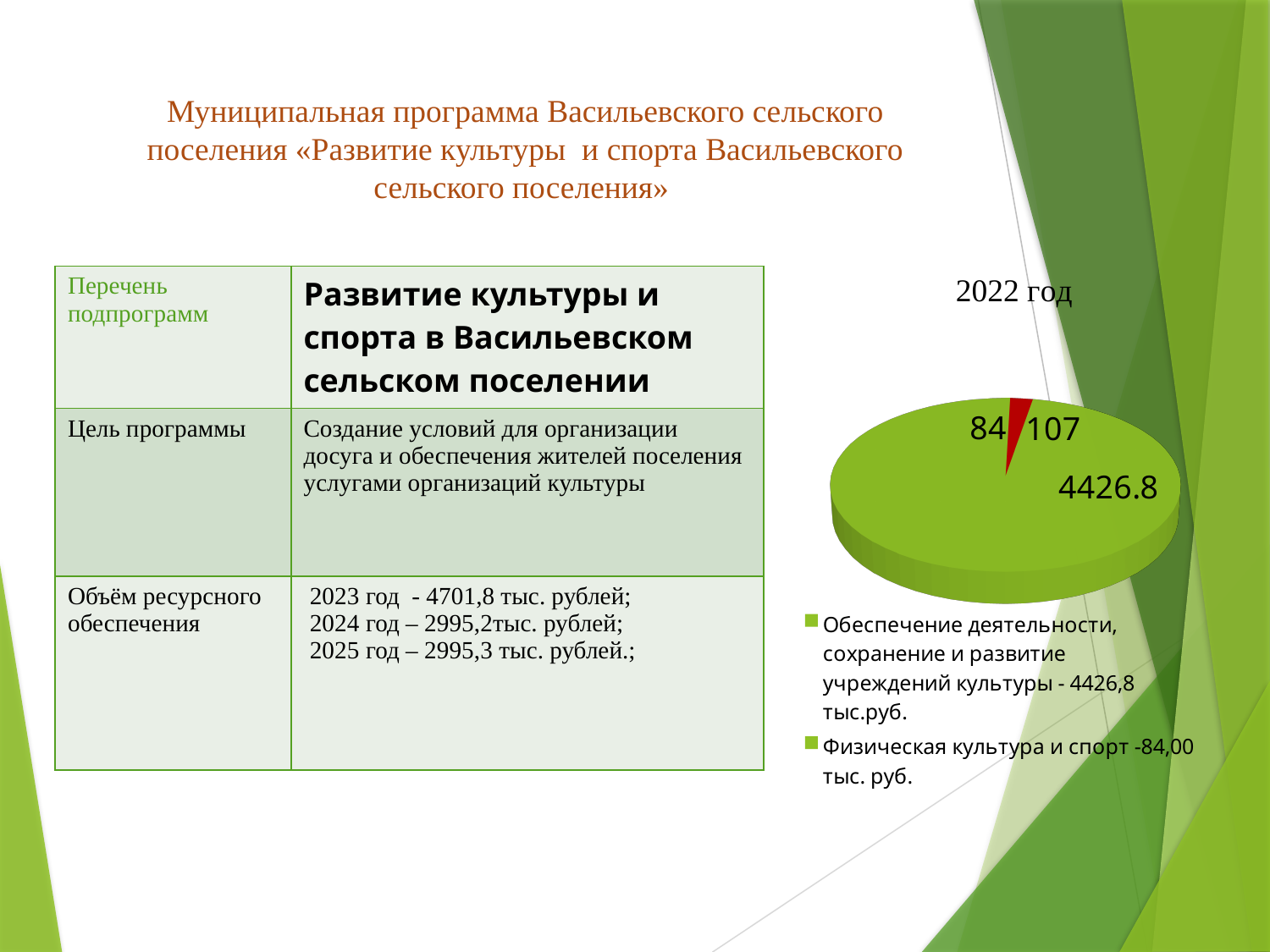
What is the difference between the value labelled 4426.8 and the value labelled 84 on the pie chart? 4342.8 What kind of chart is shown on the slide? pie chart According to the legend, what is the value for «Физическая культура и спорт»? 84,00 тыс. руб. Which is larger: the slice for «Обеспечение деятельности, сохранение и развитие учреждений культуры» or the slice for «Физическая культура и спорт»? Обеспечение деятельности, сохранение и развитие учреждений культуры What is the title of the pie chart? 2022 год According to the legend, what is the value for «Обеспечение деятельности, сохранение и развитие учреждений культуры»? 4426,8 тыс.руб. Which legend category has the largest slice in the pie chart? Обеспечение деятельности, сохранение и развитие учреждений культуры What colour is the largest slice of the pie chart? green How many data labels are printed on the pie chart? 3 How many entries does the legend of the pie chart list? 2 What is the smallest value labelled on the pie chart? 84 What value is labelled on the largest slice of the pie chart? 4426.8